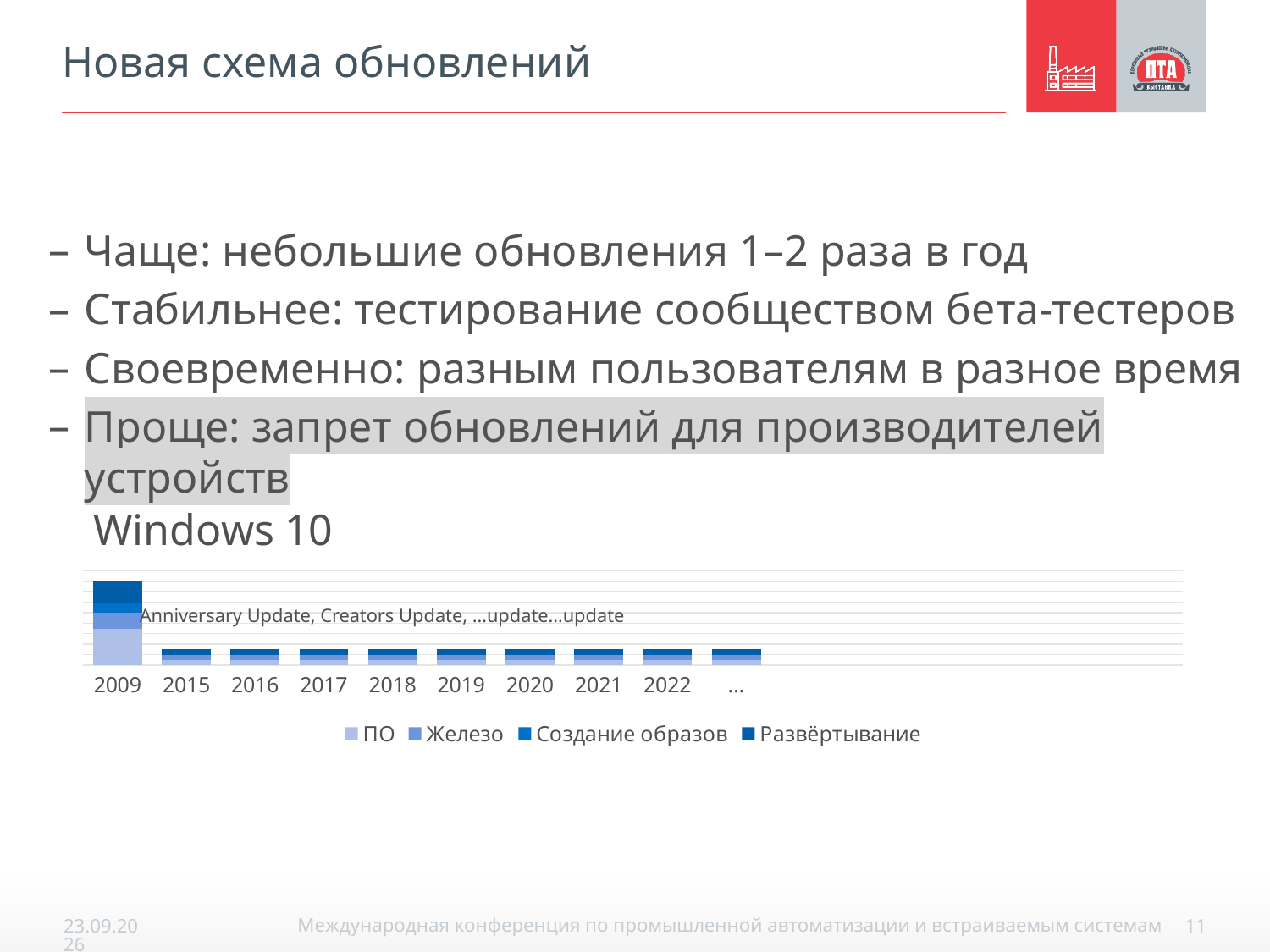
Do the bars from 2015 to 2022 rise, fall, or stay about the same? stay about the same What kind of chart is shown on the slide? stacked bar chart Which bar is taller in the chart, 2009 or 2022? 2009 What is the first category on the x axis of the chart? 2009 What are the four series listed in the chart legend? ПО, Железо, Создание образов, Развёртывание How many categories are shown along the x axis of the chart? 10 What is the title shown above the chart? Windows 10 Which category has the tallest bar in the chart? 2009 What is the last labelled year on the x axis of the chart before the '…' category? 2022 How many series does the chart legend list? 4 Which bar is taller in the chart, 2009 or 2015? 2009